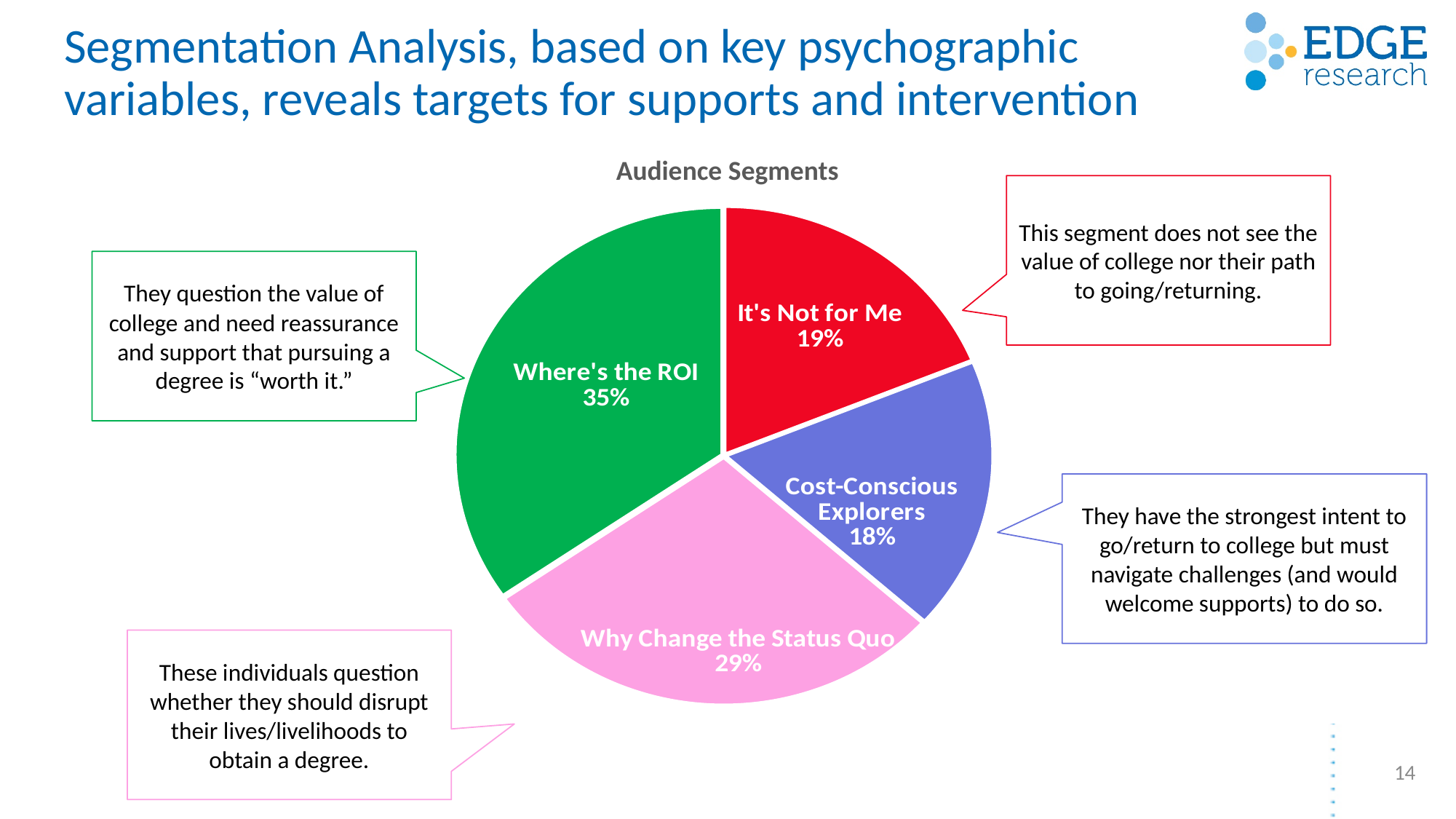
What kind of chart is shown on the slide? Pie chart What is the value shown for "Why Change the Status Quo"? 29% What is the difference in percentage points between "Where's the ROI" and "Why Change the Status Quo"? 6 percentage points What colour is the "Where's the ROI" slice? Green Which segment has the largest share of the pie? Where's the ROI How many segments does the pie chart have? 4 What is the value shown for "Cost-Conscious Explorers"? 18% What is the value shown for the "It's Not for Me" segment? 19% Which is larger, the share for "It's Not for Me" or the share for "Why Change the Status Quo"? Why Change the Status Quo What is the title of the chart? Audience Segments What share of the pie does the "Where's the ROI" segment represent? 35% Which segment has the smallest share of the pie? Cost-Conscious Explorers